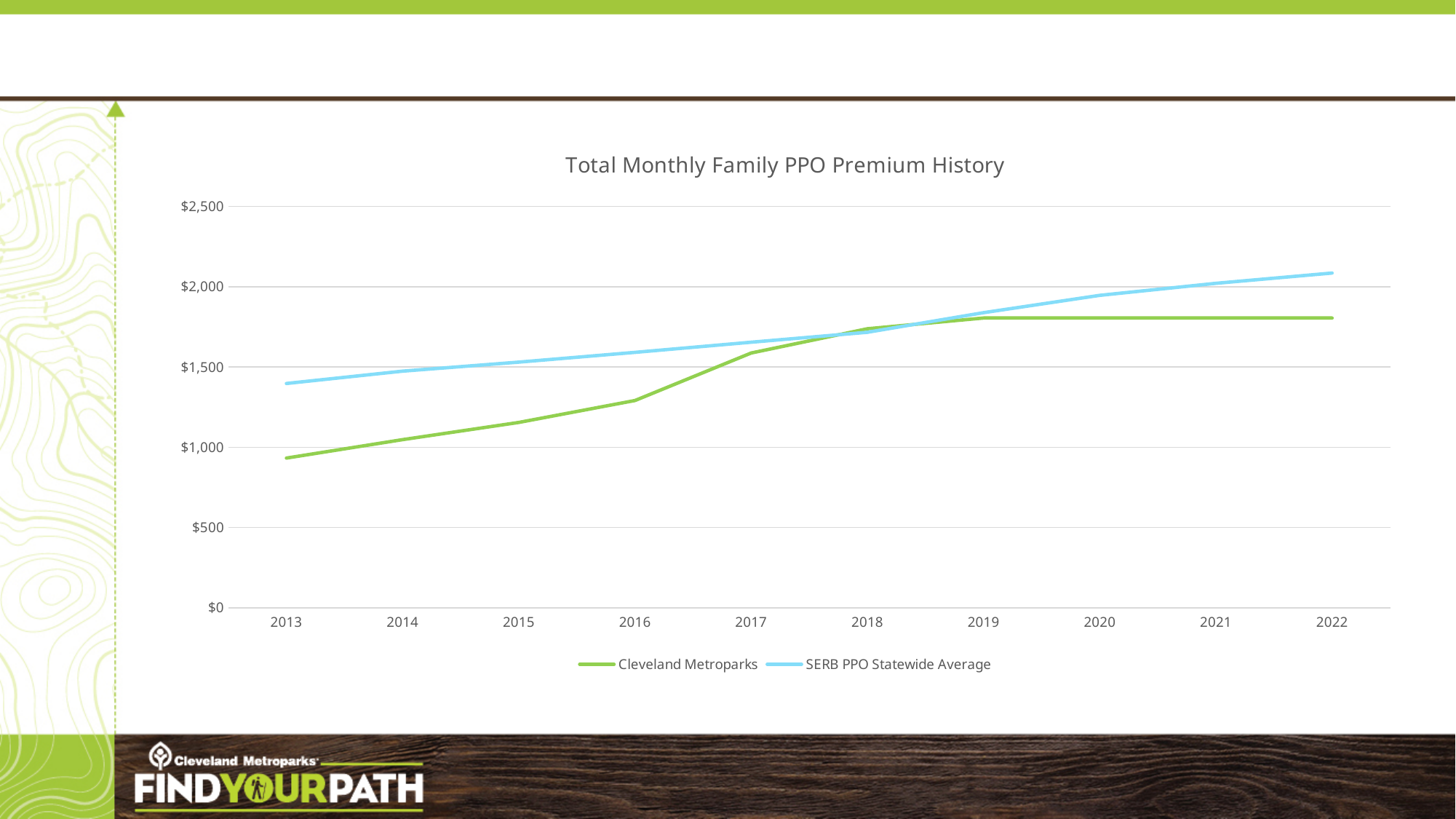
Is the value for Cleveland Metroparks in 2016 greater or less than $1,500? less In 2022, which series has the higher value, Cleveland Metroparks or SERB PPO Statewide Average? SERB PPO Statewide Average In 2013, which series has the higher value, Cleveland Metroparks or SERB PPO Statewide Average? SERB PPO Statewide Average Which series is drawn in blue? SERB PPO Statewide Average How many series does the legend list? 2 Is the value for Cleveland Metroparks in 2013 greater or less than $1,000? less What type of chart is shown on the slide? Line chart How many years are plotted along the x axis? 10 What is the title of the chart? Total Monthly Family PPO Premium History Does the SERB PPO Statewide Average line rise or fall from 2013 to 2022? Rise Is the value for Cleveland Metroparks in 2022 greater or less than $2,000? less